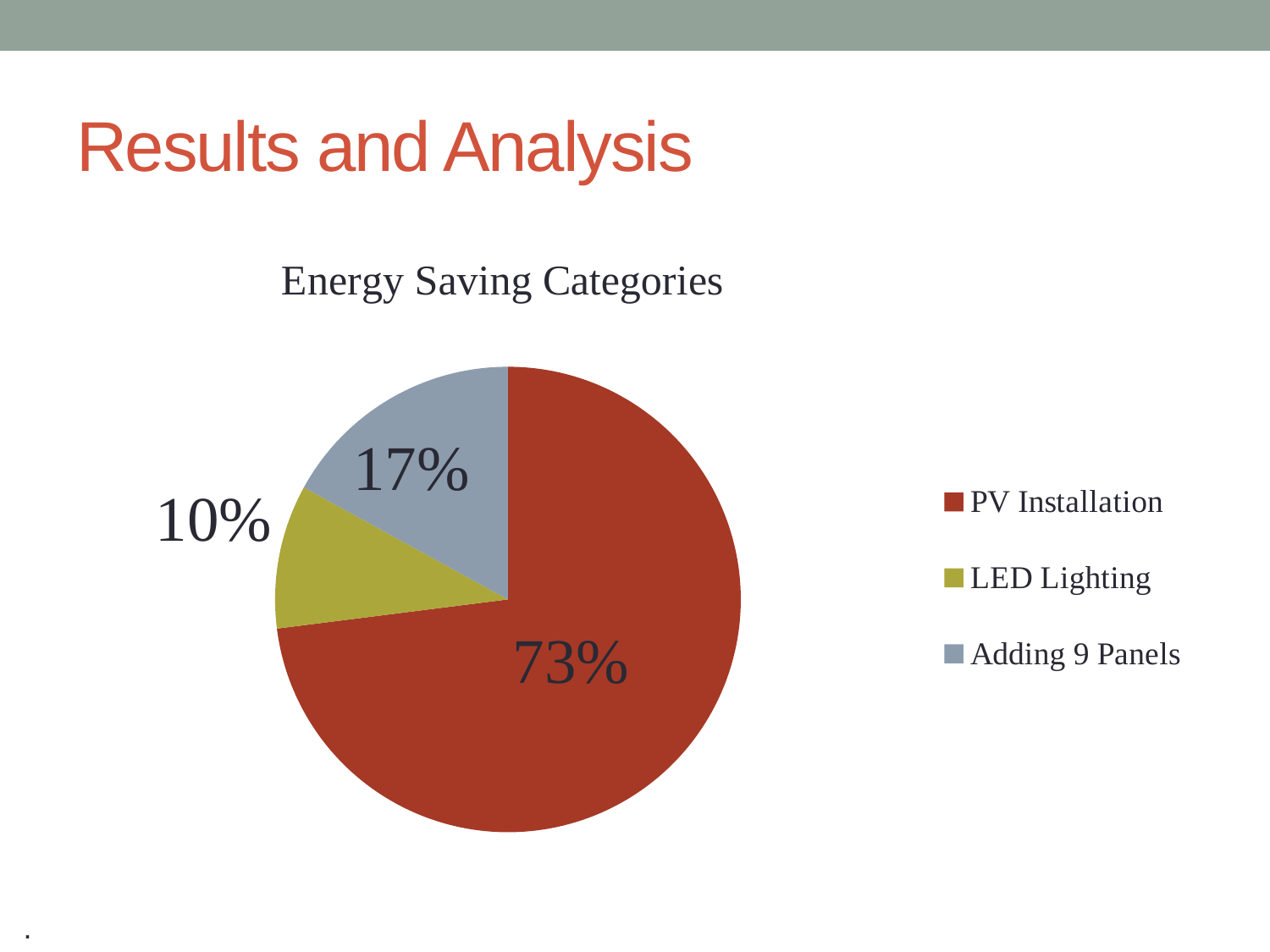
What is the title of the chart? Energy Saving Categories What share of the pie does Adding 9 Panels represent? 17% Which category has the largest share of the pie? PV Installation What share of the pie does PV Installation represent? 73% Which is larger, the share for Adding 9 Panels or the share for LED Lighting? Adding 9 Panels What is the difference between the share for Adding 9 Panels and the share for LED Lighting? 7% What share of the pie does LED Lighting represent? 10% What type of chart is shown on the slide? pie chart Which category has the smallest share of the pie? LED Lighting Which category is shown in red in the pie chart? PV Installation How many categories are shown in the pie chart? 3 What is the difference between the share for PV Installation and the share for Adding 9 Panels? 56%